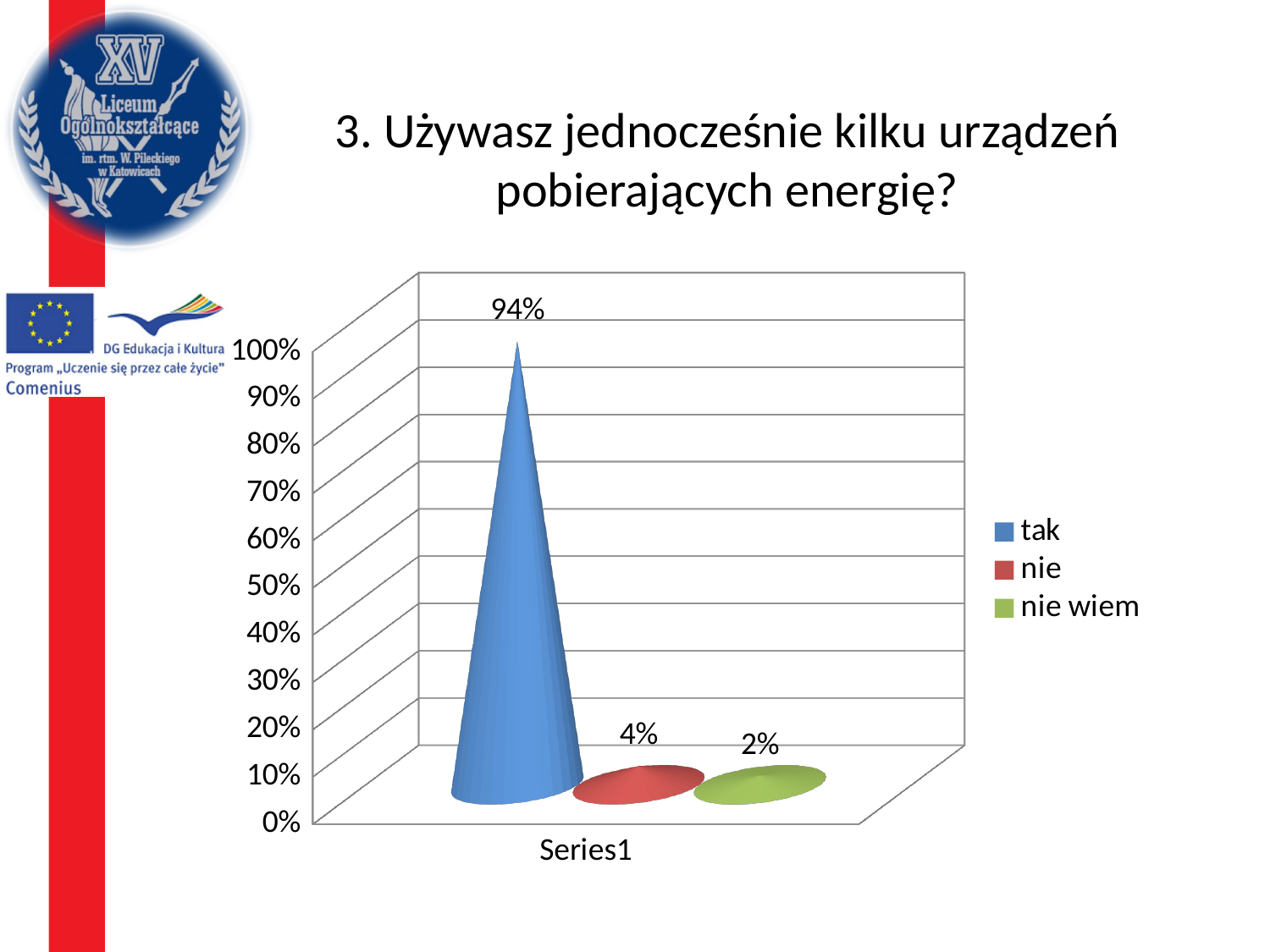
Which answer has the lowest value? nie wiem How many series does the legend list? 3 Which answer has the highest value? tak What is the difference between the values for "nie" and "nie wiem"? 2% What is the difference between the values for "tak" and "nie"? 90% What kind of chart is shown on the slide? bar chart Which is larger, the value for "nie" or the value for "nie wiem"? nie What is the value for "tak"? 94% What is the value for "nie"? 4% What is the value for "nie wiem"? 2% Is the value for "tak" greater or less than 90%? greater What is the title of the chart? 3. Używasz jednocześnie kilku urządzeń pobierających energię?